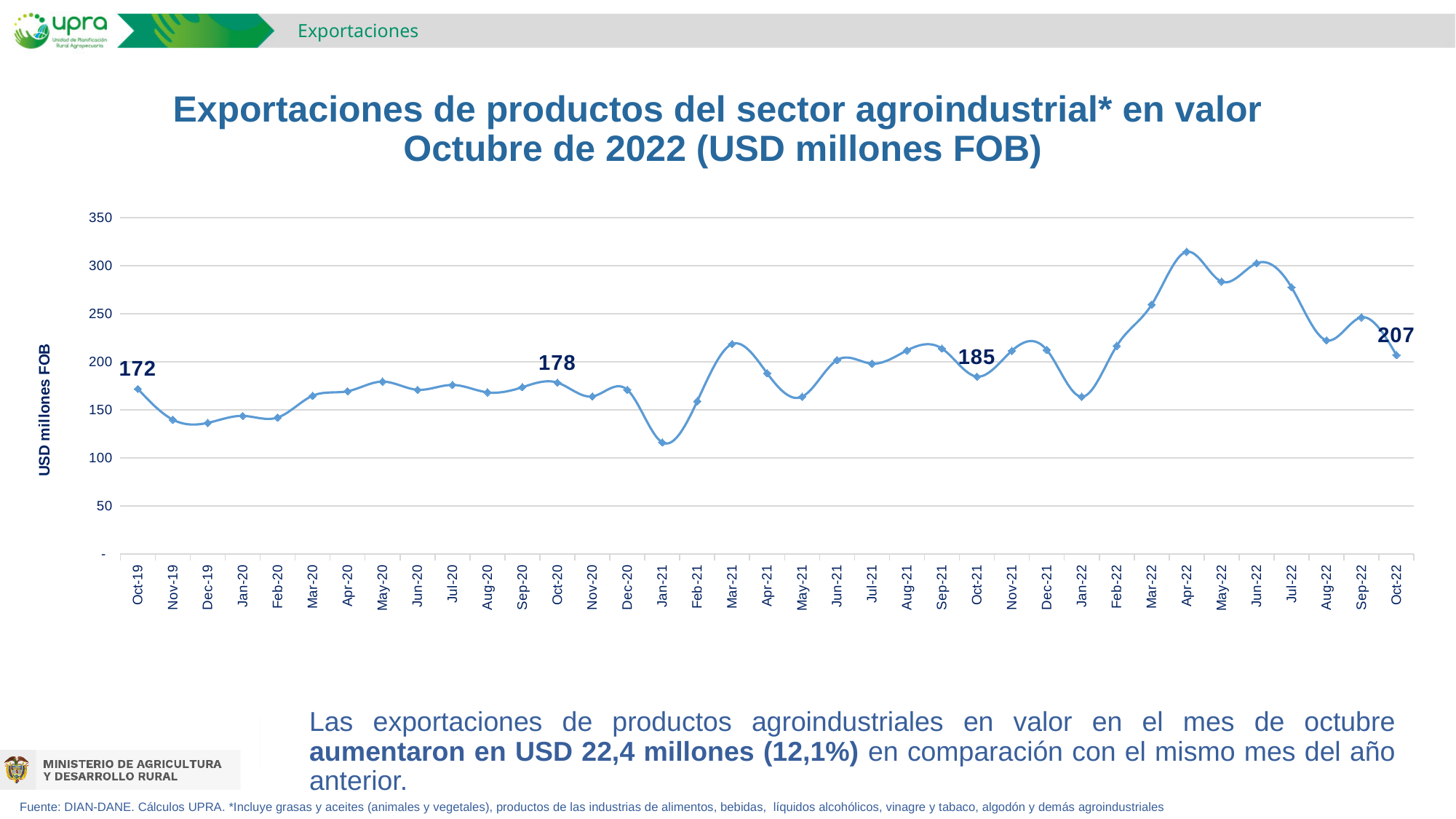
What is the value for Oct-20? 178 Is the value for Jan-21 greater or less than 150? less What is the difference between the values for Oct-22 and Oct-21? 22 What kind of chart is shown on the slide? line chart Is the value for Apr-22 greater or less than 300? greater Which month has the highest value on the chart? Apr-22 What is the value for Oct-22? 207 What is the title of the vertical axis? USD millones FOB What is the value for Oct-21? 185 Which is larger, the value for Oct-21 or the value for Oct-20? Oct-21 Which month has the lowest value on the chart? Jan-21 What is the value for Oct-19? 172